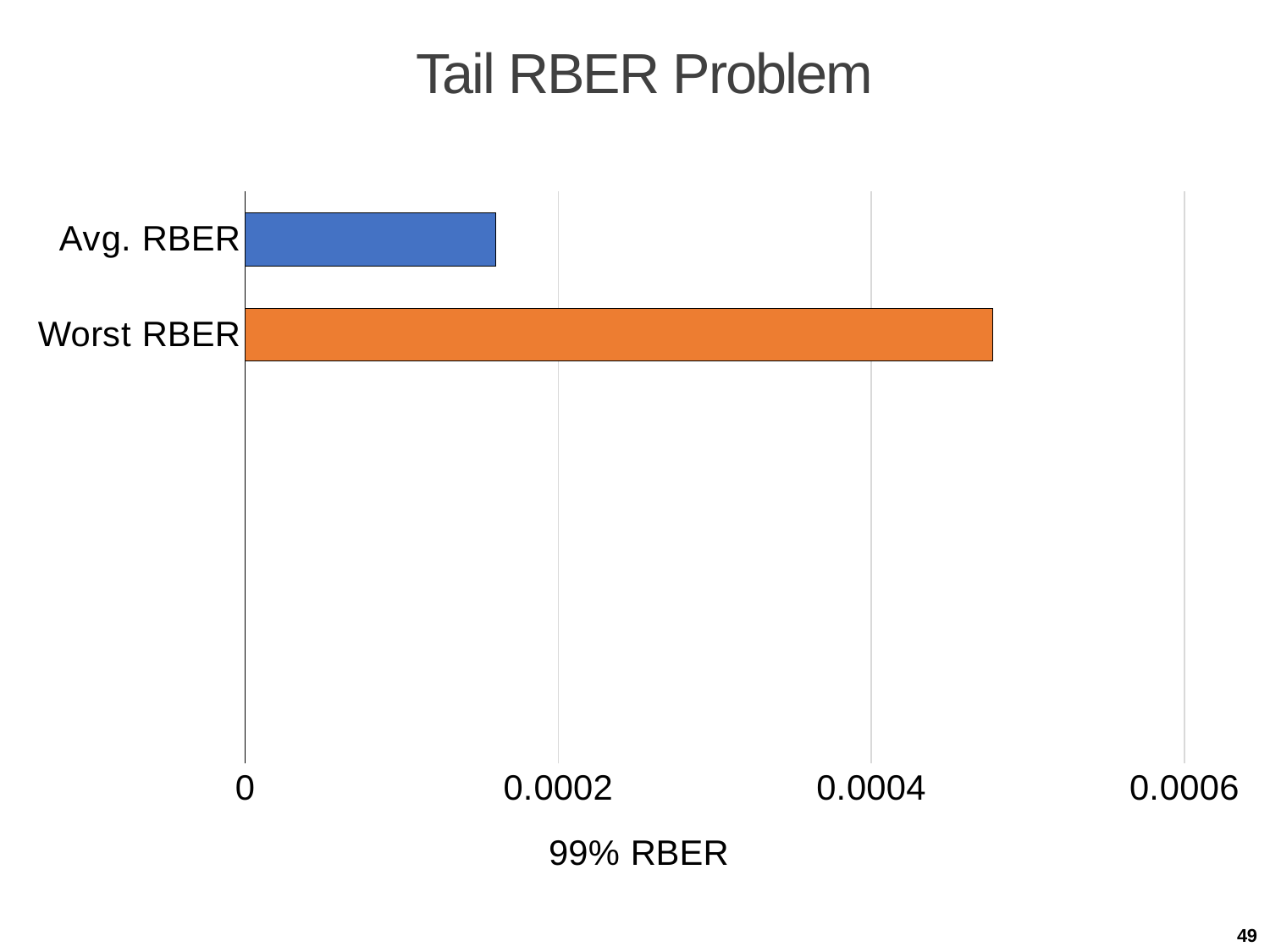
Which category has the lowest value? Avg. RBER Which category has the highest value? Worst RBER How many categories are plotted in the chart? 2 What is the title of the slide? Tail RBER Problem What is the label on the horizontal axis of the chart? 99% RBER Is the value for Worst RBER greater or less than 0.0004? greater Which is larger, the value for Avg. RBER or the value for Worst RBER? Worst RBER Is the value for Worst RBER greater or less than 0.0006? less Is the value for Avg. RBER greater or less than 0.0002? less What kind of chart is shown on the slide? bar chart